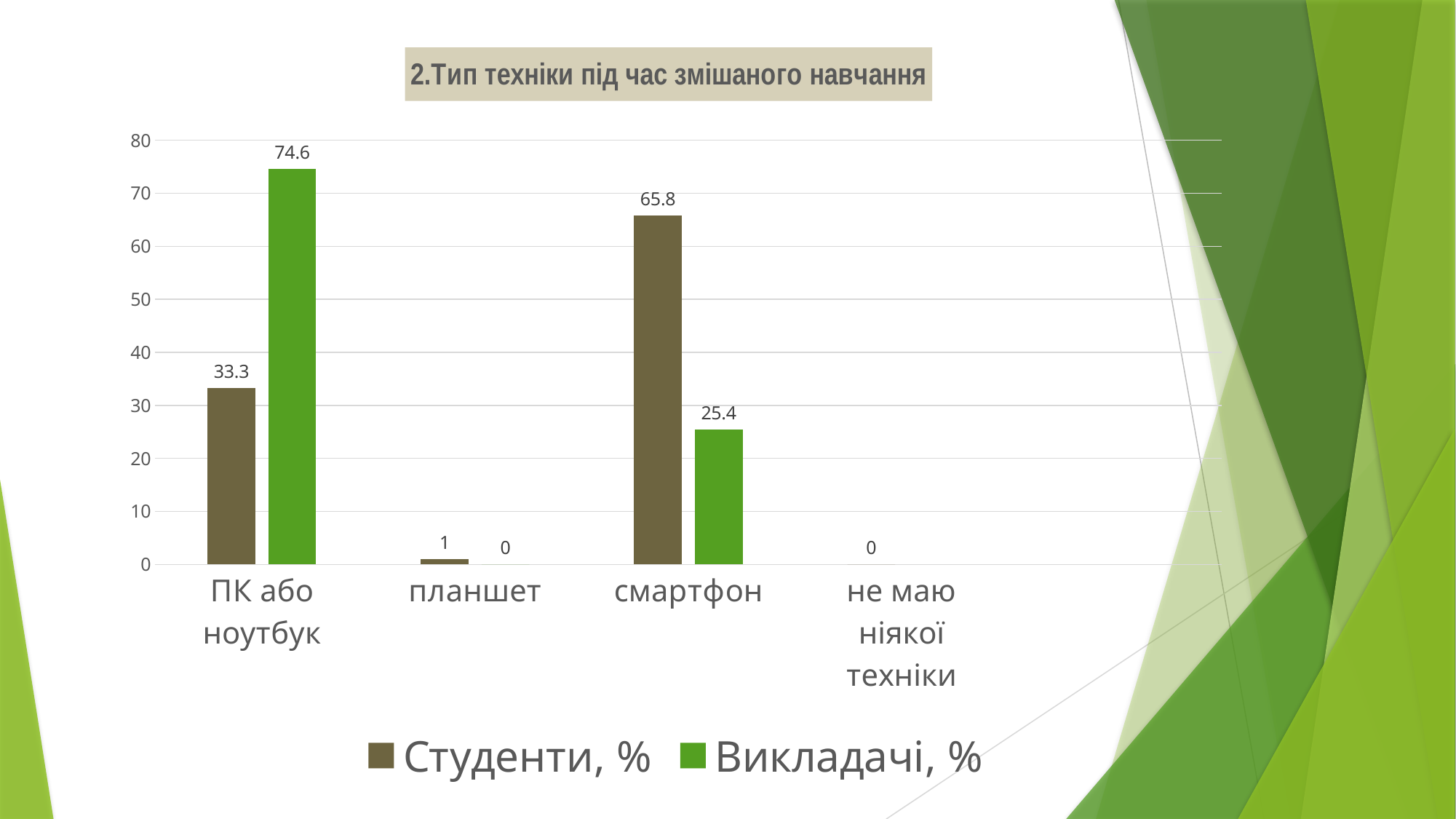
How many categories are shown on the x axis? 4 Which category has the highest value for Викладачі, %? ПК або ноутбук For смартфон, which series has the larger value, Студенти, % or Викладачі, %? Студенти, % What type of chart is shown on the slide? bar chart What is the difference between the Викладачі, % and Студенти, % values for ПК або ноутбук? 41.3 What is the value for Студенти, % for планшет? 1 What is the value for Студенти, % for смартфон? 65.8 What is the value for Викладачі, % for ПК або ноутбук? 74.6 What is the value for Студенти, % for ПК або ноутбук? 33.3 Which category has the highest value for Студенти, %? смартфон What is the value for Викладачі, % for смартфон? 25.4 How many series does the legend list? 2